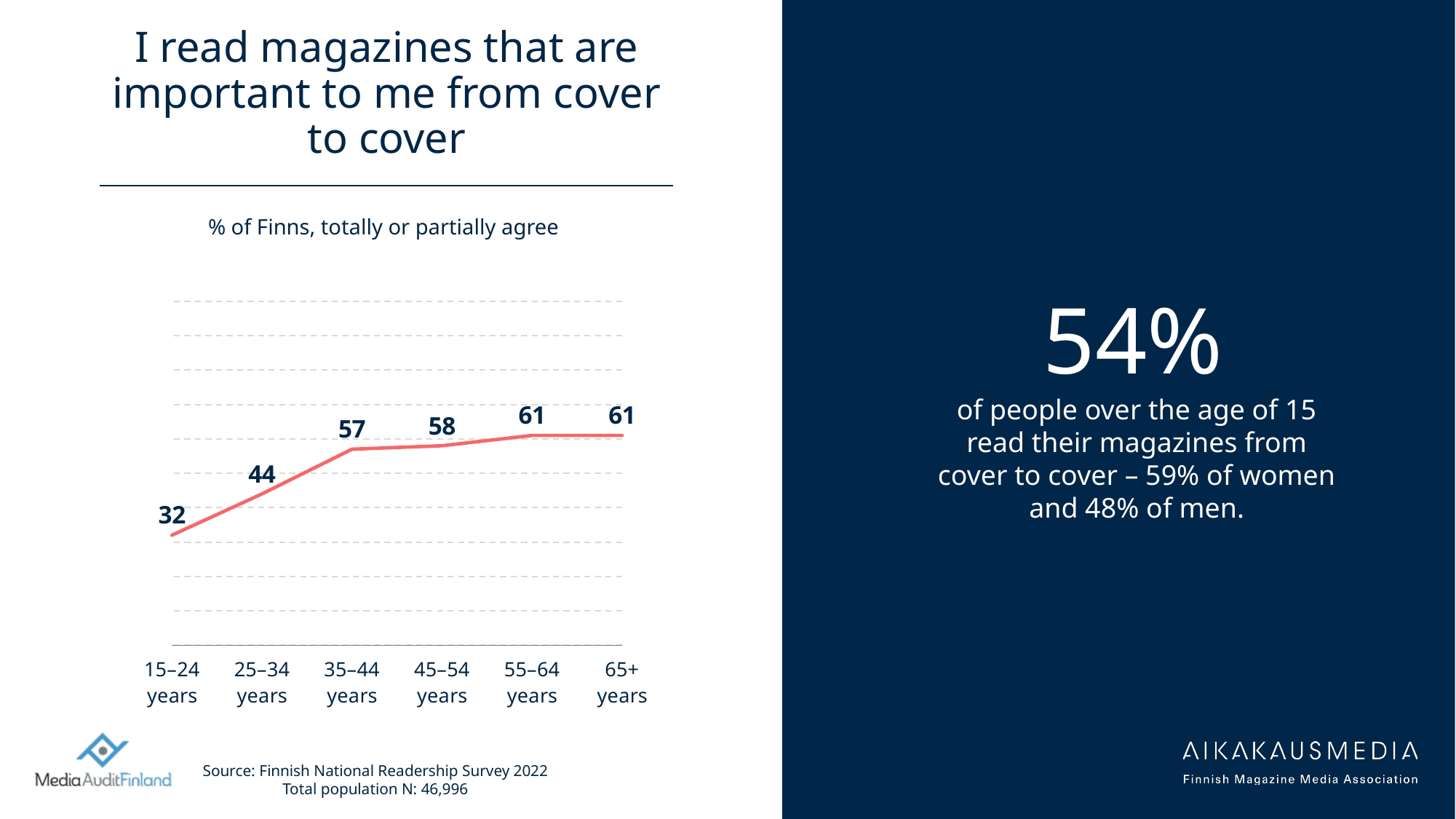
What is the value for the 15–24 years age group? 32 What is the value for the 45–54 years age group? 58 What is the value for the 35–44 years age group? 57 Do the values rise or fall as age increases along the x axis? Rise What is the difference between the values for 35–44 years and 25–34 years? 13 Which age group has the lowest value? 15–24 years What is the subtitle shown above the chart describing what is measured? % of Finns, totally or partially agree What colour is the line in the chart? Red What kind of chart is shown on the slide? Line chart Which is larger, the value for 25–34 years or the value for 45–54 years? 45–54 years What is the difference between the values for 65+ years and 15–24 years? 29 How many age groups are plotted on the chart? 6